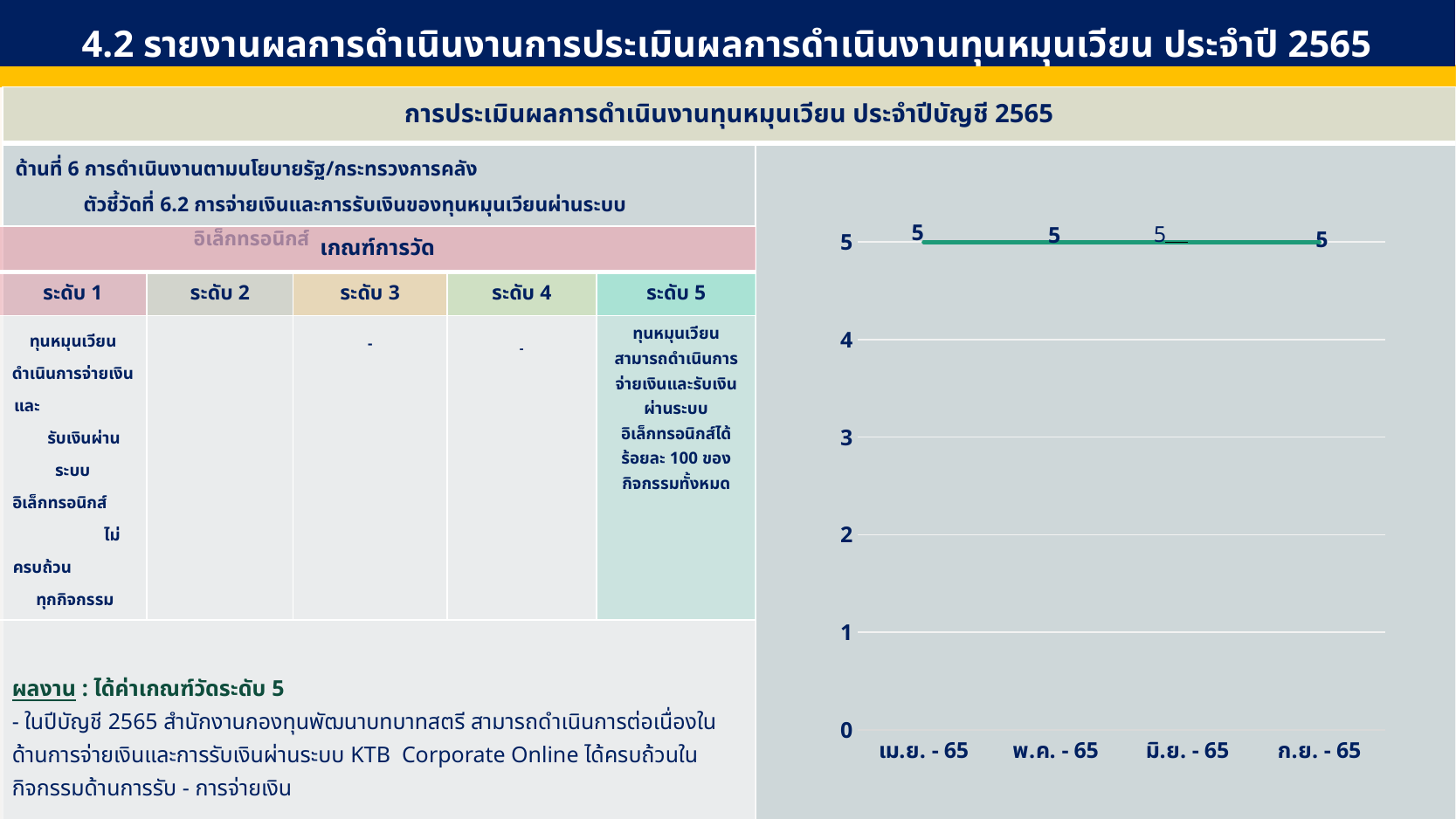
What kind of chart is shown on the right side of the slide? line chart Do the values rise, fall, or stay flat from เม.ย. - 65 to ก.ย. - 65? stay flat What is the difference between the values for เม.ย. - 65 and ก.ย. - 65? 0 What is the value for พ.ค. - 65? 5 Is the value for พ.ค. - 65 greater or less than 3? greater What is the value for เม.ย. - 65? 5 What is the value for ก.ย. - 65? 5 What is the label of the first category on the x axis of the line chart? เม.ย. - 65 How many points are plotted on the line chart? 4 What is the highest value shown on the y axis of the line chart? 5 What is the value for มิ.ย. - 65? 5